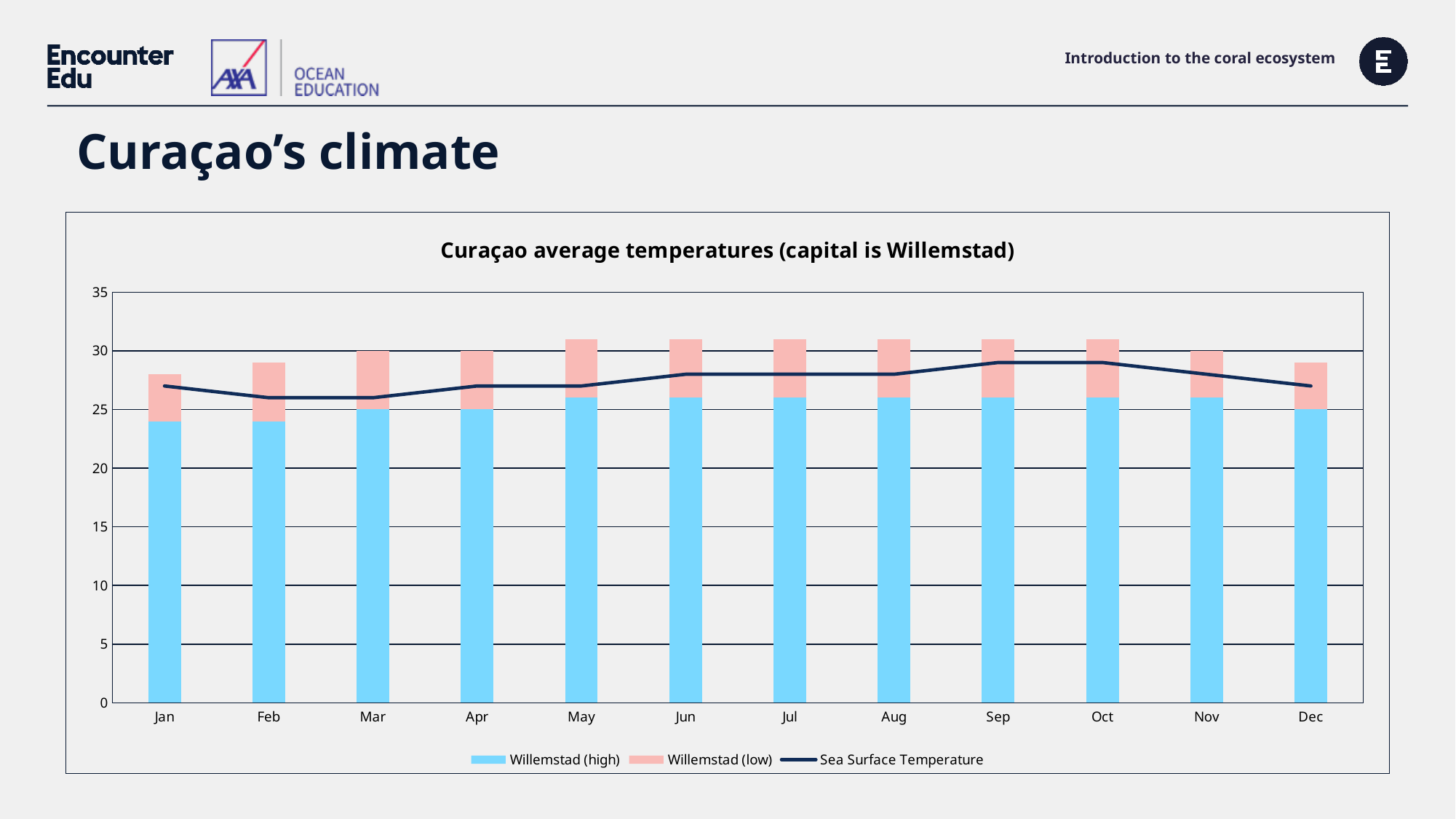
Does the Sea Surface Temperature rise or fall from Mar to Sep? rise Is the Sea Surface Temperature for Sep greater or less than 30? less Which is larger, the Willemstad (high) value for Jan or for Jun? Jun How many months are shown on the x axis of the chart? 12 Is the Willemstad (high) value for Jan greater or less than 25? less What is the title of the chart? Curaçao average temperatures (capital is Willemstad) How many series does the chart's legend list? 3 What kind of chart is shown on the slide? A bar chart combined with a line What is the total height of the stacked bar for Apr? 30 Is the Sea Surface Temperature for Feb greater or less than 25? greater Which series is drawn as a dark navy line? Sea Surface Temperature What is the Willemstad (high) value for Mar? 25